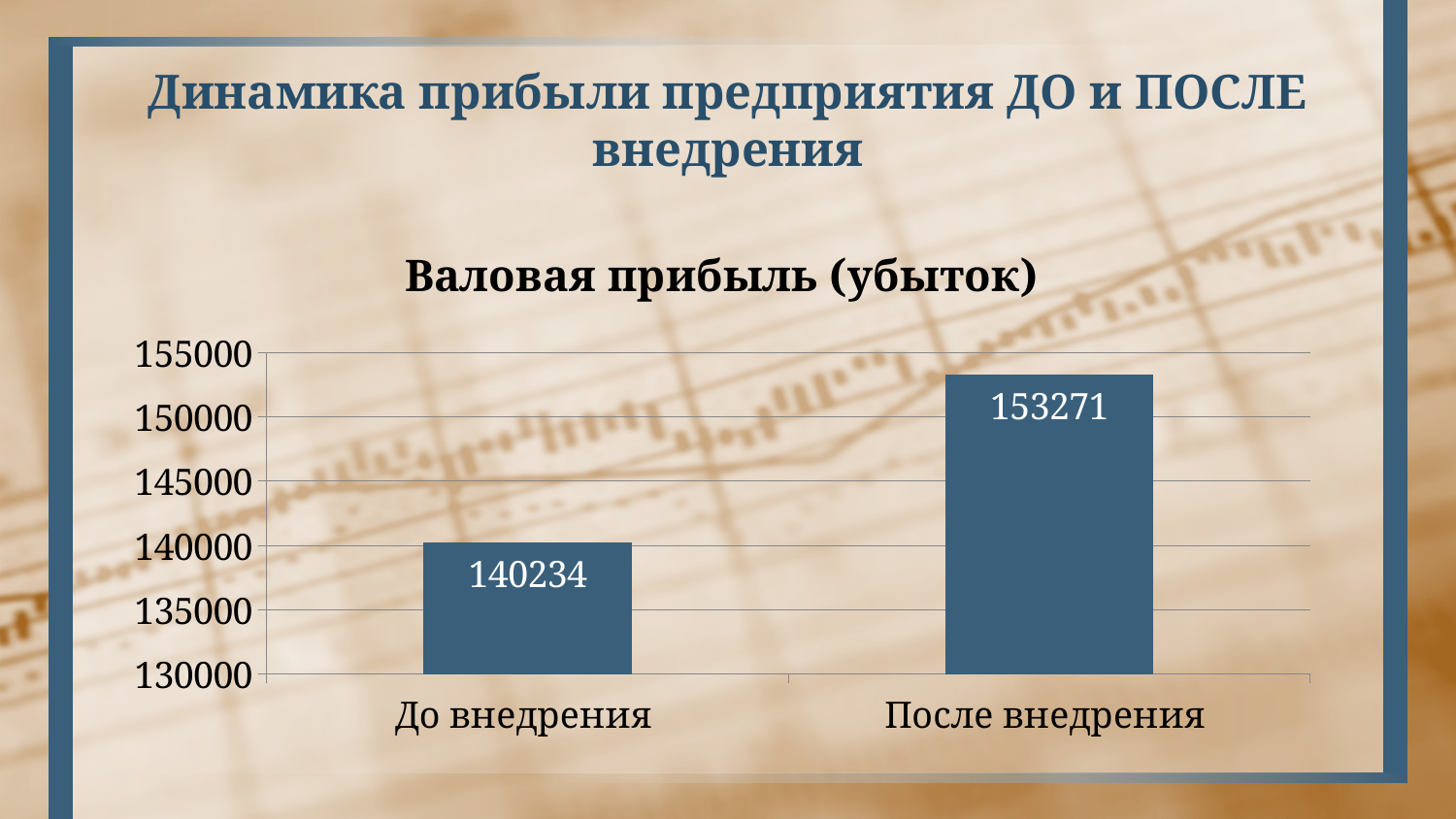
Which category has the lowest value? До внедрения Do the values rise or fall from "До внедрения" to "После внедрения"? rise What is the title of the chart? Валовая прибыль (убыток) Is the value for "До внедрения" greater or less than 145000? less Is the value for "После внедрения" greater or less than 150000? greater What is the difference between the values for "После внедрения" and "До внедрения"? 13037 Which is larger: the value for "До внедрения" or for "После внедрения"? После внедрения What kind of chart is shown on the slide? bar chart How many categories are shown on the chart? 2 Which category has the highest value? После внедрения What is the value for "После внедрения"? 153271 What is the value for "До внедрения"? 140234